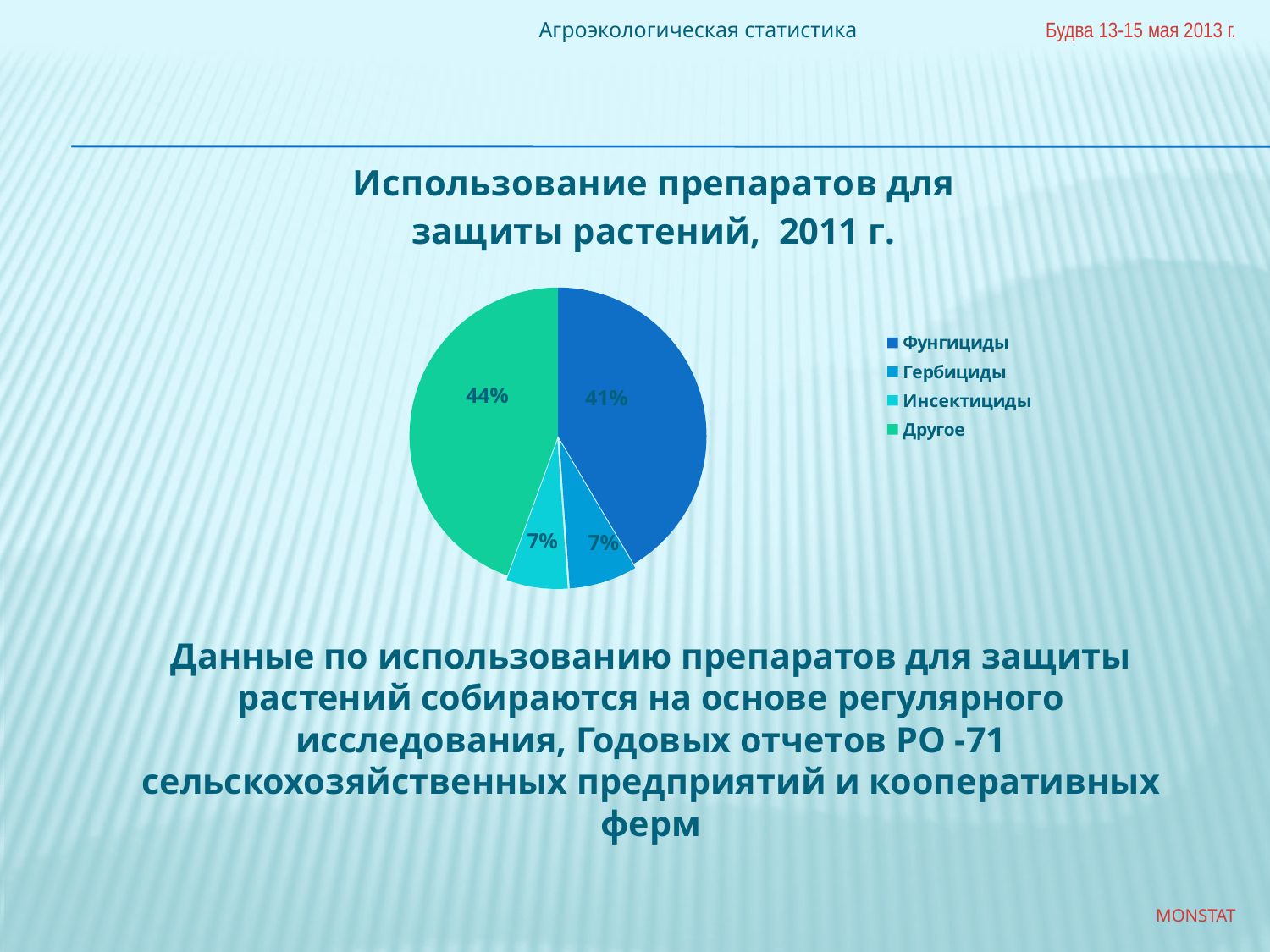
How many entries does the legend list? 4 How many categories are shown in the pie chart? 4 What is the difference in percentage points between Фунгициды and Гербициды? 34 What is the title of the chart? Использование препаратов для защиты растений, 2011 г. What share of the pie does Фунгициды account for? 41% What is the value shown for Гербициды? 7% What is the value shown for Инсектициды? 7% Which category has the largest slice of the pie? Другое What is the difference in percentage points between Другое and Фунгициды? 3 Which is larger, the slice for Другое or the slice for Фунгициды? Другое What share of the pie does Другое account for? 44% What kind of chart is shown on the slide? Pie chart